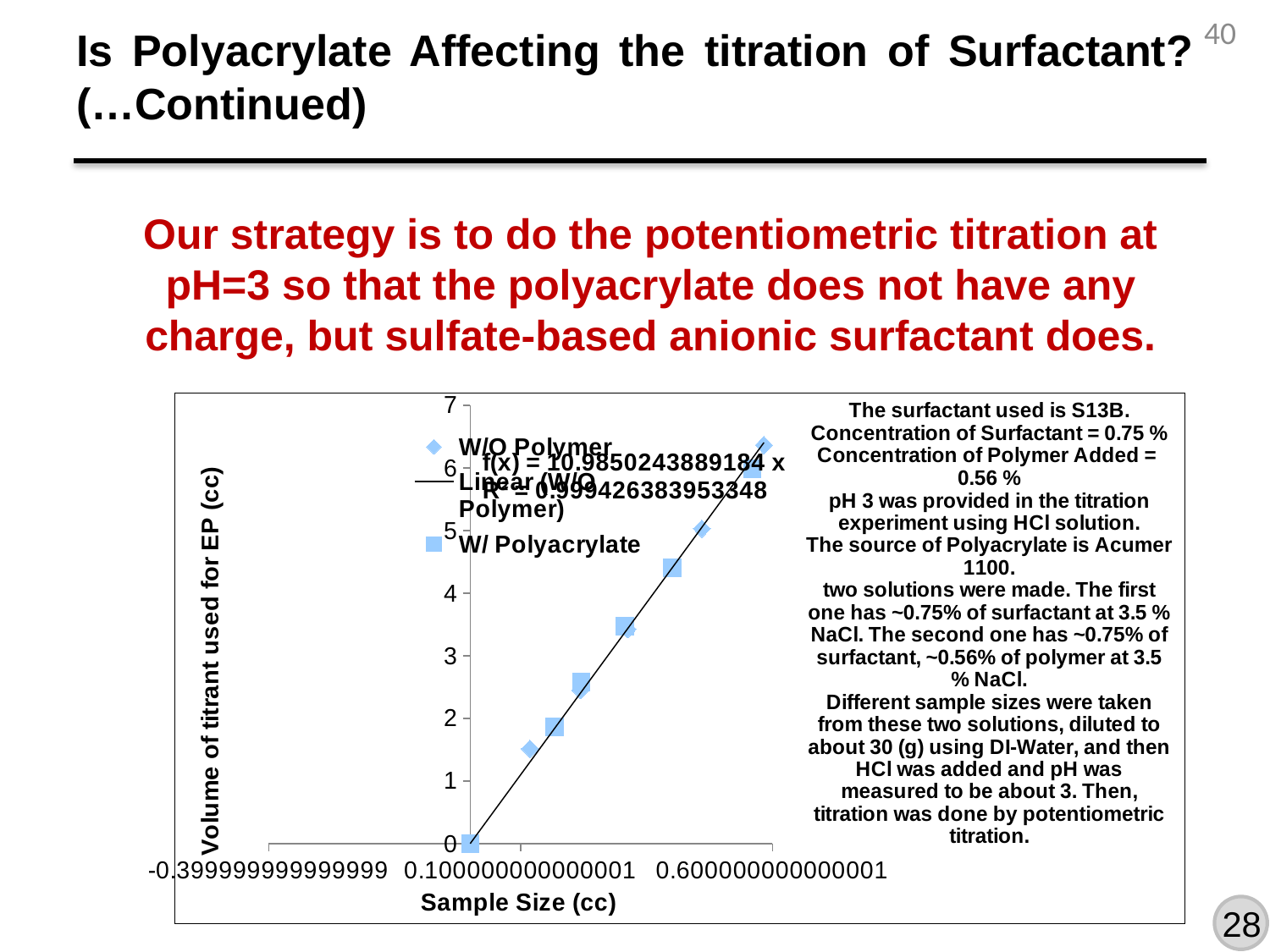
Is the volume of titrant for the W/ Polyacrylate point at a sample size of about 0.5 cc greater or less than 4? greater What is the title of the vertical axis of the chart? Volume of titrant used for EP (cc) Which series in the legend is drawn with a fitted straight line? Linear (W/O Polymer) What is the highest tick value shown on the vertical axis of the chart? 7 Is the volume of titrant for the W/O Polymer point at a sample size of about 0.15 cc greater or less than 2? less How many entries does the chart legend list? 3 What is the equation of the linear trendline printed on the chart? f(x) = 10.9850243889184 x What is the R² value printed on the chart for the linear fit? 0.999426383953348 Is the volume of titrant for the W/ Polyacrylate point at a sample size of about 0.5 cc greater or less than 5? less What is the title of the horizontal axis of the chart? Sample Size (cc) What kind of chart is shown on the slide? scatter chart Do the plotted values rise or fall as Sample Size increases along the x axis? rise